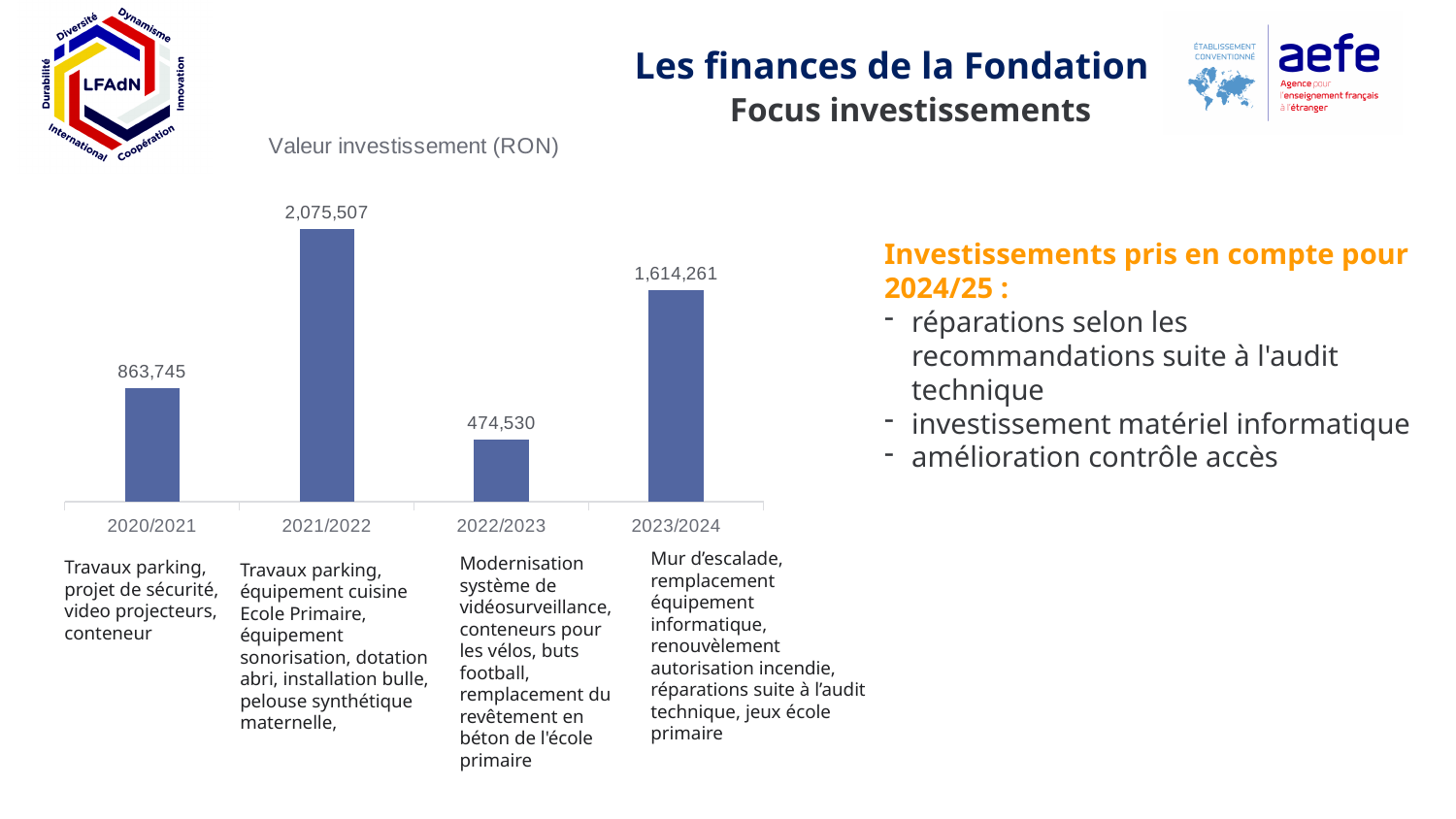
What is the value for 2022/2023 in the chart? 474,530 What is the title of the chart? Valeur investissement (RON) Which year has the highest investment value? 2021/2022 What is the value for 2020/2021 in the chart? 863,745 What is the value for 2021/2022 in the chart? 2,075,507 Which year has the lowest investment value? 2022/2023 What is the difference between the values for 2021/2022 and 2020/2021? 1,211,762 How many years are shown in the chart? 4 What is the value for 2023/2024 in the chart? 1,614,261 What is the difference between the values for 2023/2024 and 2022/2023? 1,139,731 Which is larger, the value for 2020/2021 or the value for 2023/2024? 2023/2024 What kind of chart is shown on the slide? bar chart